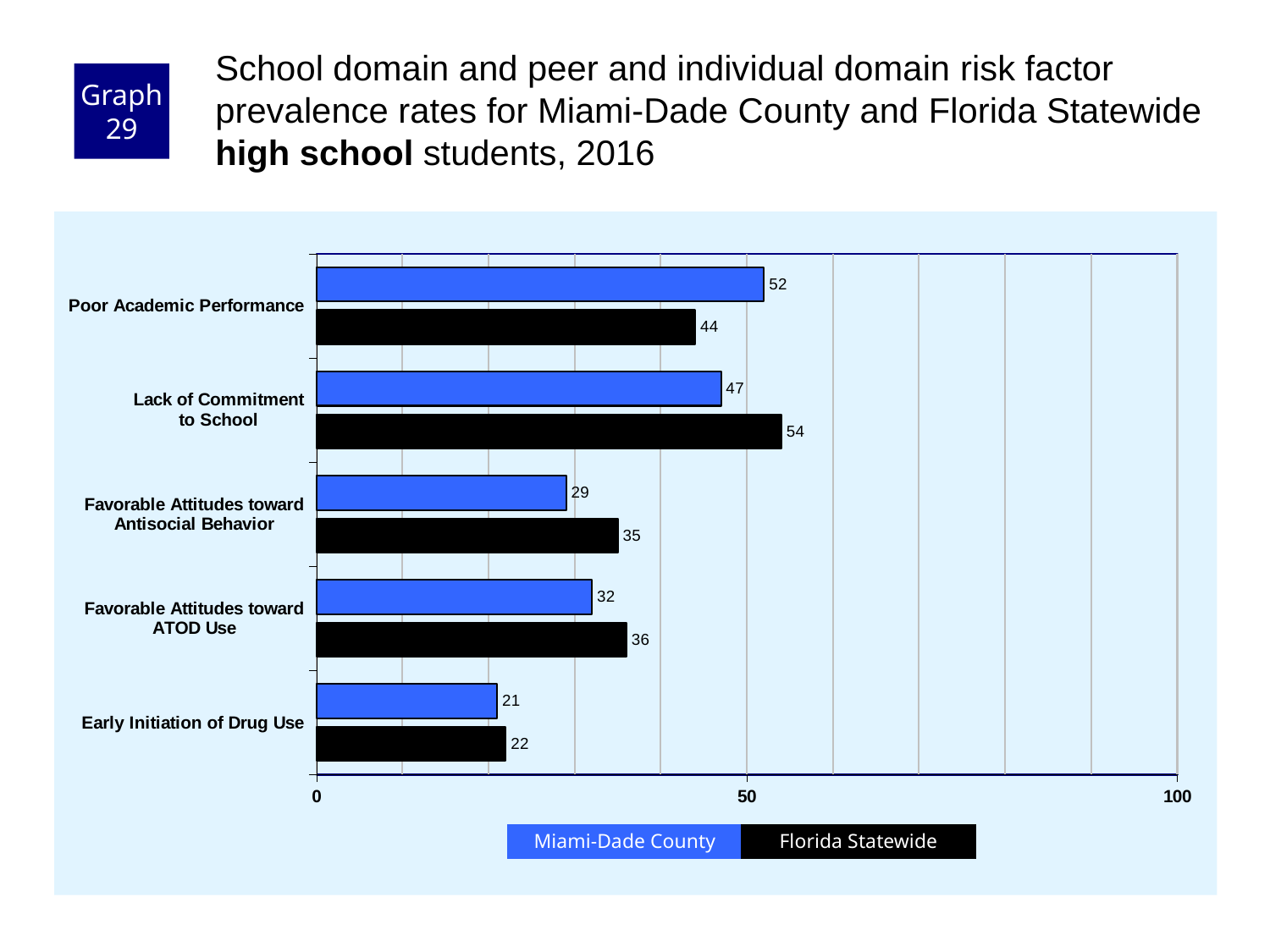
For Favorable Attitudes toward Antisocial Behavior, which is larger: Miami-Dade County or Florida Statewide? Florida Statewide Which colour represents Florida Statewide in the chart? black Which category has the lowest Miami-Dade County value? Early Initiation of Drug Use What is the Florida Statewide value for Lack of Commitment to School? 54 What is the Miami-Dade County value for Poor Academic Performance? 52 What is the Miami-Dade County value for Early Initiation of Drug Use? 21 How many series does the legend list? 2 What is the difference between the Miami-Dade County and Florida Statewide values for Poor Academic Performance? 8 Which category has the highest Florida Statewide value? Lack of Commitment to School What kind of chart is shown on the slide? bar chart Is the Florida Statewide value for Favorable Attitudes toward ATOD Use greater or less than 50? less How many risk factor categories are shown on the chart? 5